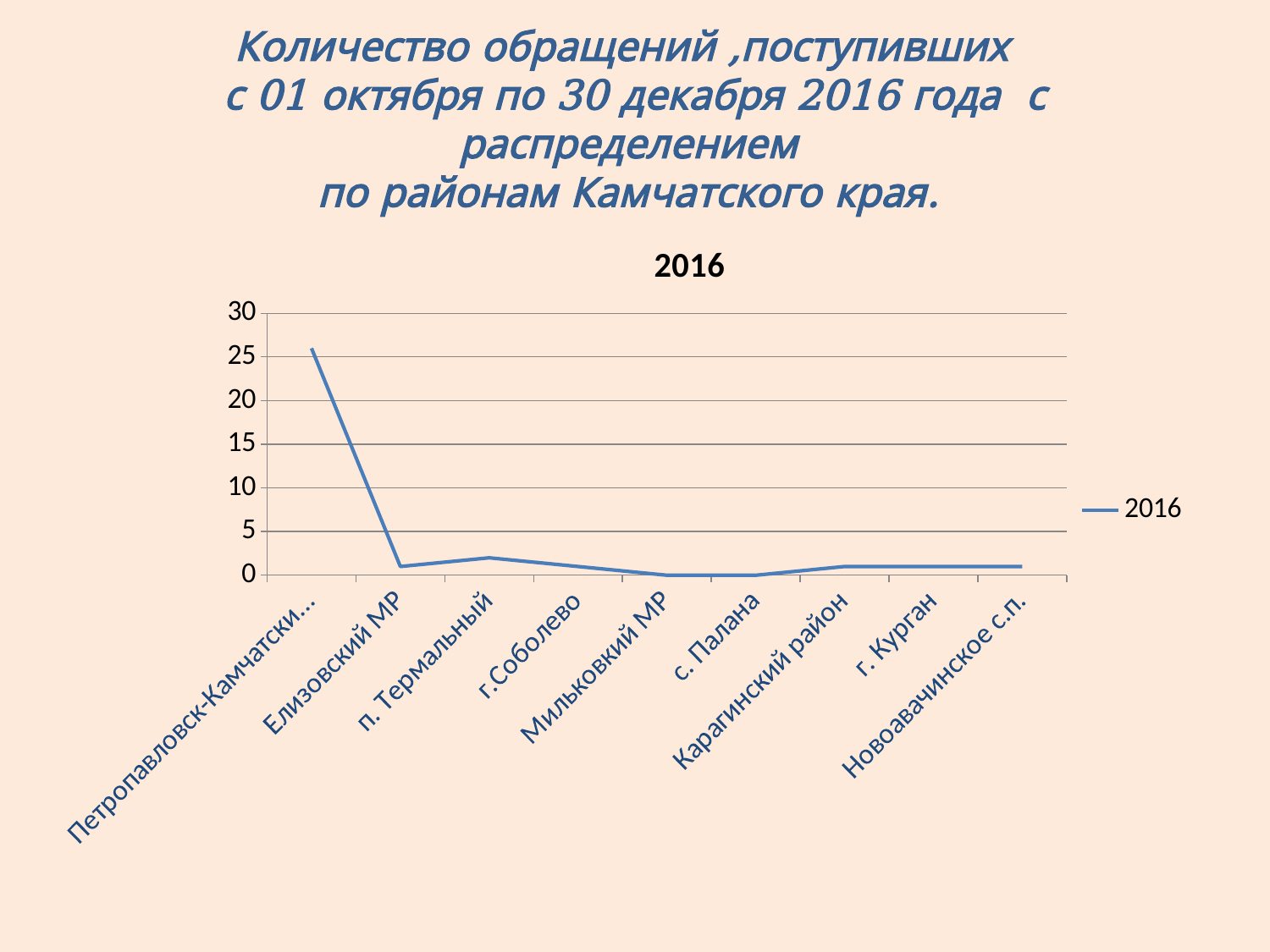
What is the title shown directly above the chart? 2016 Which category has the highest value? Петропавловск-Камчатски... How many categories (districts) are plotted along the x axis? 9 Is the value for Петропавловск-Камчатски... greater or less than 20? greater Does the line generally rise or fall from the first category to the last? fall How many series does the legend list? 1 Is the value for Елизовский МР greater or less than 5? less What kind of chart is shown on the slide? line chart Which is larger, the value for Петропавловск-Камчатски... or the value for Елизовский МР? Петропавловск-Камчатски... What is the value for с. Палана? 0 What is the value for Мильковкий МР? 0 Is the value for Карагинский район greater or less than 5? less